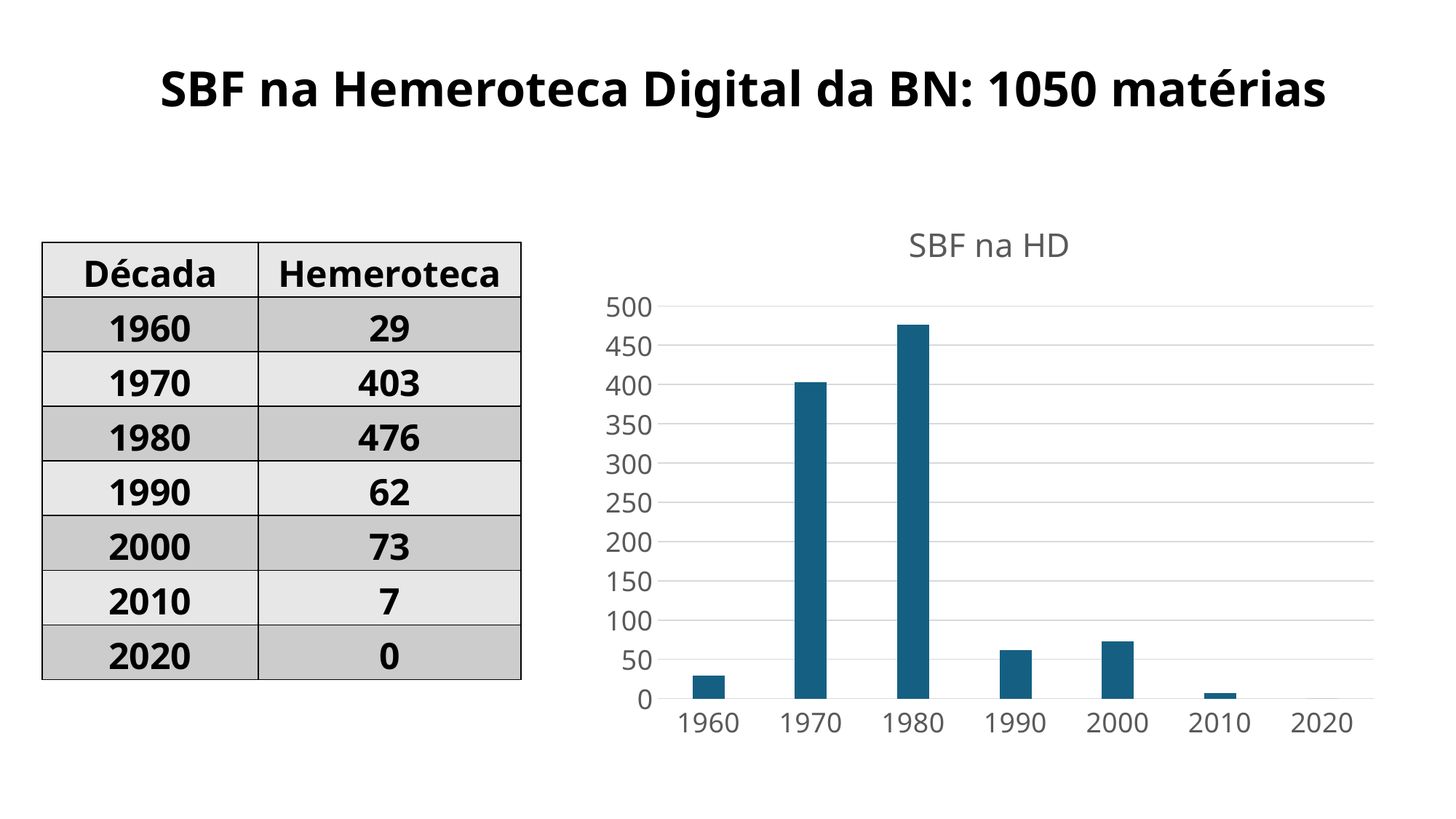
What kind of chart is shown on the slide? bar chart Do the values rise or fall from 1980 to 2020 along the x axis? fall What is the value for 2010 in the chart? 7 How many decades are shown on the x axis of the chart? 7 What is the value for 1970 in the chart? 403 Is the value for 1970 greater or less than 400? greater Which decade has the lowest value in the chart? 2020 Which decade has the highest value in the chart? 1980 What is the value for 1980 in the chart? 476 What is the difference between the values for 1980 and 1970? 73 What is the title of the chart? SBF na HD Which is larger, the value for 1990 or the value for 2000? 2000